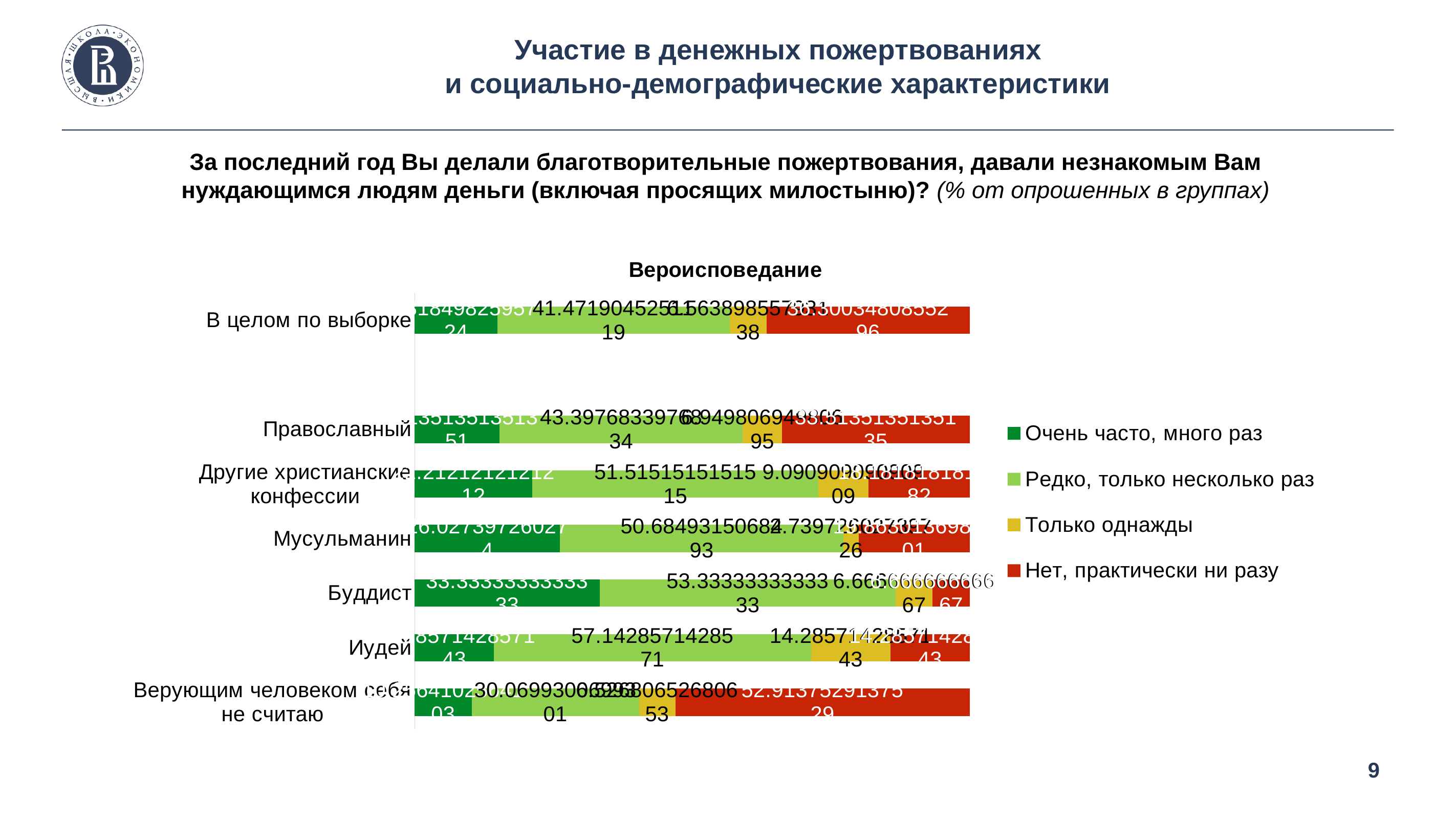
Which category has the largest "Редко, только несколько раз" (light green) segment? Иудей Which category has the largest "Нет, практически ни разу" (red) segment? Верующим человеком себя не считаю What kind of chart is shown under the title "Вероисповедание"? Stacked bar chart Is the "Нет, практически ни разу" segment larger for Православный or for Мусульманин? Православный Is the "Очень часто, много раз" segment larger for Буддист or for Православный? Буддист Is the "Редко, только несколько раз" segment larger for Иудей or for Мусульманин? Иудей What is the title of the chart on the slide? Вероисповедание Which category has the largest "Очень часто, много раз" (dark green) segment? Буддист How many categories (rows) are plotted in the "Вероисповедание" chart? 7 How many series does the legend of the "Вероисповедание" chart list? 4 Which category has the smallest "Нет, практически ни разу" (red) segment? Буддист Which colour represents the series "Нет, практически ни разу" in the chart? Red